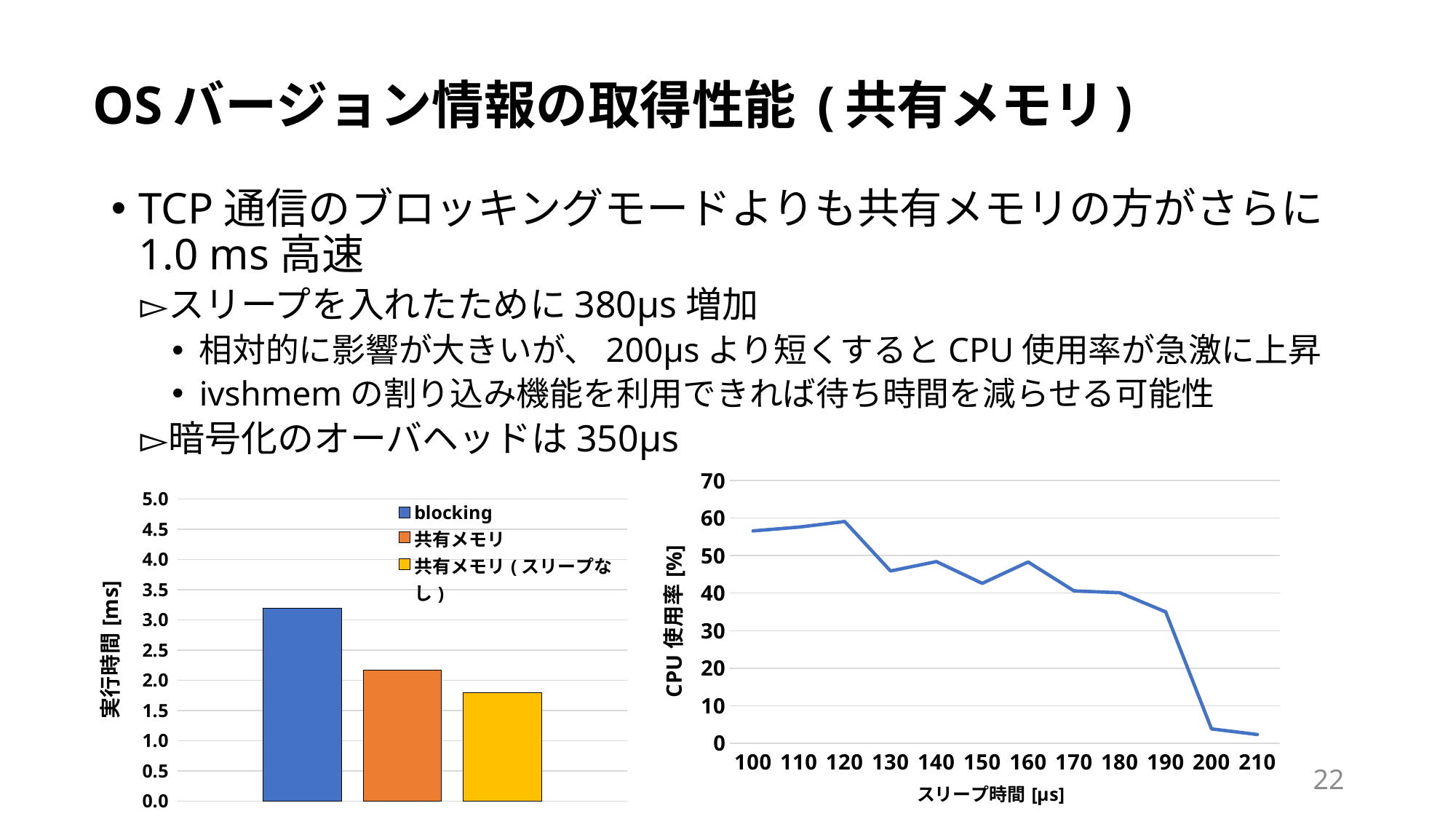
In the left bar chart, is the value for blocking greater or less than 3.0? greater In the right line chart, how many sleep-time points are plotted along the x axis? 12 In the left bar chart, is the value for 共有メモリ greater or less than 2.5? less In the left bar chart, which series has the lowest 実行時間? 共有メモリ ( スリープなし ) What kind of chart is the right chart on the slide? line chart In the right line chart, is the CPU 使用率 at スリープ時間 200 greater or less than 10? less In the right line chart, does CPU 使用率 generally rise or fall as スリープ時間 increases? fall In the left bar chart, how many series does the legend list? 3 What kind of chart is the left chart on the slide? bar chart In the left bar chart, which is larger, the value for 共有メモリ or the value for 共有メモリ ( スリープなし )? 共有メモリ In the left bar chart, which series has the highest 実行時間? blocking What is the y-axis title of the right line chart? CPU 使用率 [%]